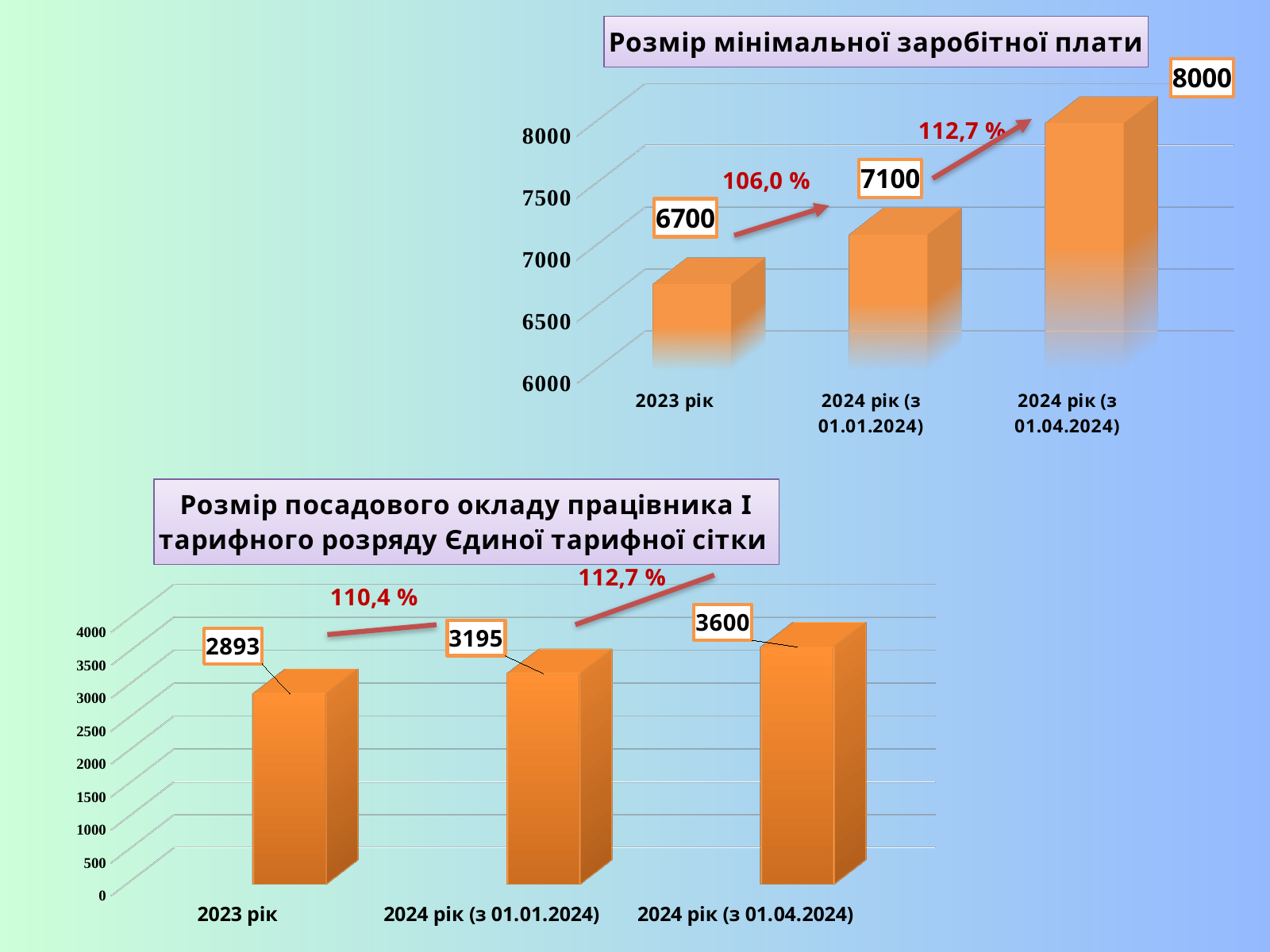
What kind of chart is the bottom chart about the посадовий оклад of a worker of the I тарифний розряд? bar chart In the bottom chart about the посадовий оклад of a worker of the I тарифний розряд, what is the value for 2023 рік? 2893 In the chart titled "Розмір мінімальної заробітної плати", what is the value for 2024 рік (з 01.04.2024)? 8000 In the chart titled "Розмір мінімальної заробітної плати", what is the value for 2023 рік? 6700 In the bottom chart about the посадовий оклад of a worker of the I тарифний розряд, what is the value for 2024 рік (з 01.01.2024)? 3195 In the bottom chart about the посадовий оклад of a worker of the I тарифний розряд, which category has the highest value? 2024 рік (з 01.04.2024) In the chart titled "Розмір мінімальної заробітної плати", what percentage is printed on the arrow between 2023 рік and 2024 рік (з 01.01.2024)? 106,0 % In the chart titled "Розмір мінімальної заробітної плати", how many categories are shown on the x axis? 3 In the chart titled "Розмір мінімальної заробітної плати", do the values rise or fall from left to right? rise In the bottom chart about the посадовий оклад of a worker of the I тарифний розряд, what is the difference between the values for 2024 рік (з 01.01.2024) and 2023 рік? 302 In the chart titled "Розмір мінімальної заробітної плати", what is the difference between the values for 2024 рік (з 01.04.2024) and 2024 рік (з 01.01.2024)? 900 In the chart titled "Розмір мінімальної заробітної плати", which category has the lowest value? 2023 рік